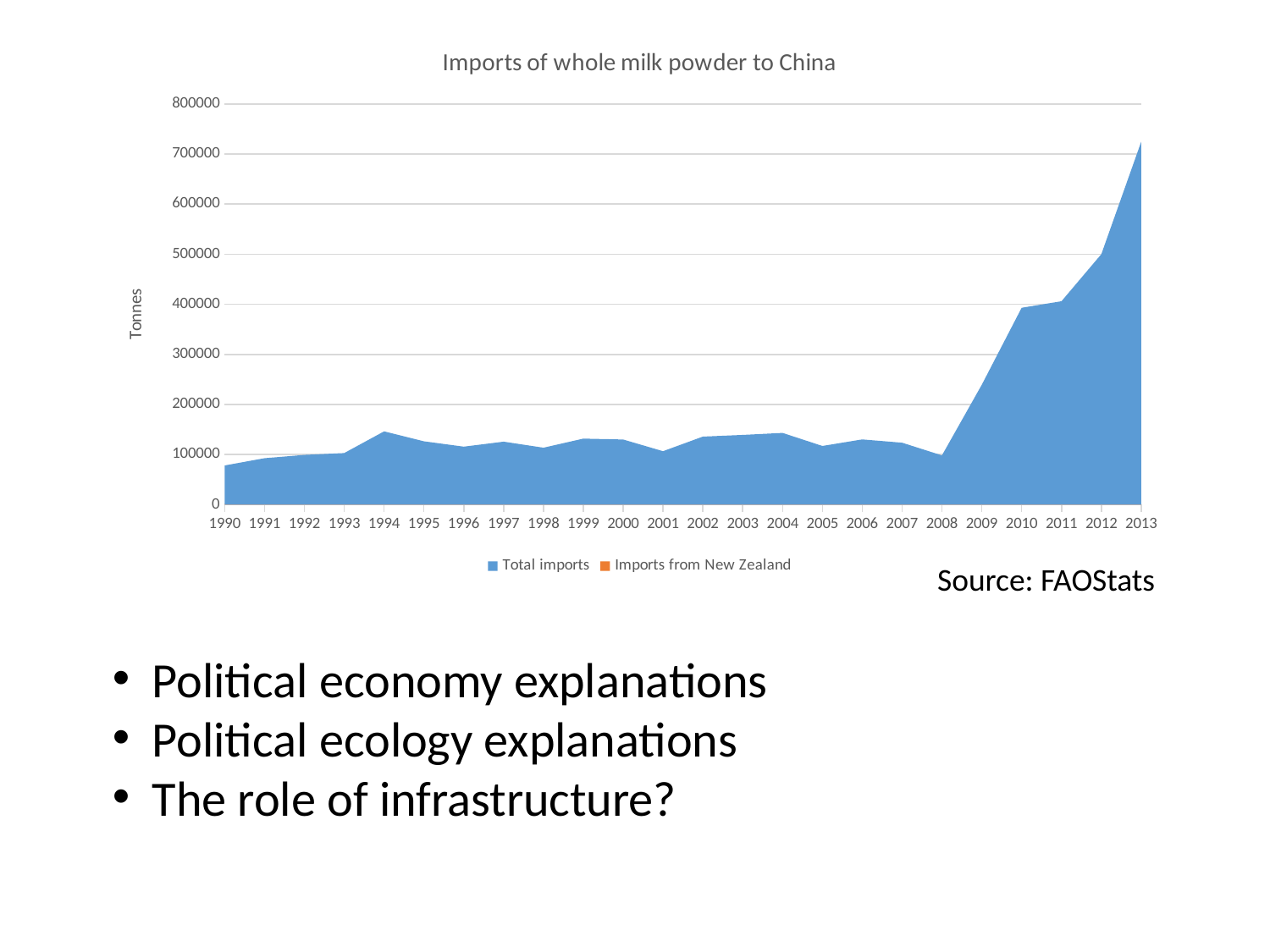
Do the Total imports values rise or fall from 2008 to 2013? rise Is the value for Total imports in 2008 greater or less than 200000? less Is the value for Total imports in 1994 greater or less than 100000? greater How many series does the legend list? 2 Is the value for Total imports in 2010 greater or less than 300000? greater What kind of chart is shown on the slide? Area chart Which year has the highest value for Total imports? 2013 What is the title of the chart? Imports of whole milk powder to China How many years are shown on the x axis? 24 Which year has the lowest value for Total imports? 1990 Which year has the larger value for Total imports, 2010 or 2013? 2013